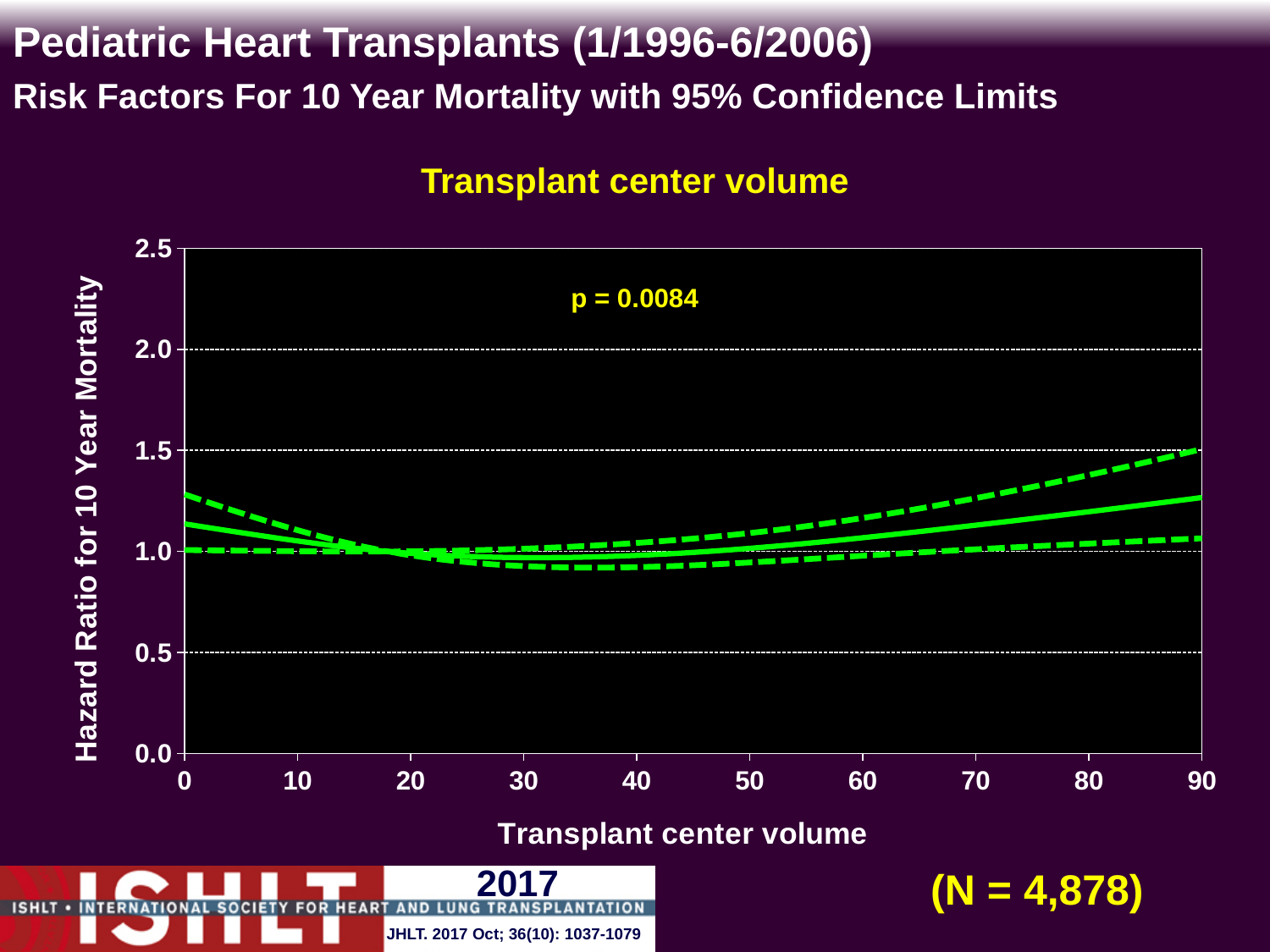
What is the highest transplant center volume shown on the x-axis? 90 Is the hazard ratio (solid line) at a transplant center volume of 90 greater or less than 1.0? greater What is the p-value shown on the chart? p = 0.0084 Does the hazard ratio (solid line) rise or fall as transplant center volume increases from 0 to 20? fall Is the upper 95% confidence limit (upper dashed line) at a transplant center volume of 90 greater or less than 1.0? greater How many lines are plotted on the chart? 3 What is the sample size (N) shown on the slide? 4,878 Is the hazard ratio (solid line) at a transplant center volume of 0 greater or less than 1.5? less Does the hazard ratio (solid line) rise or fall as transplant center volume increases from 30 to 90? rise What kind of chart is shown on the slide? line chart